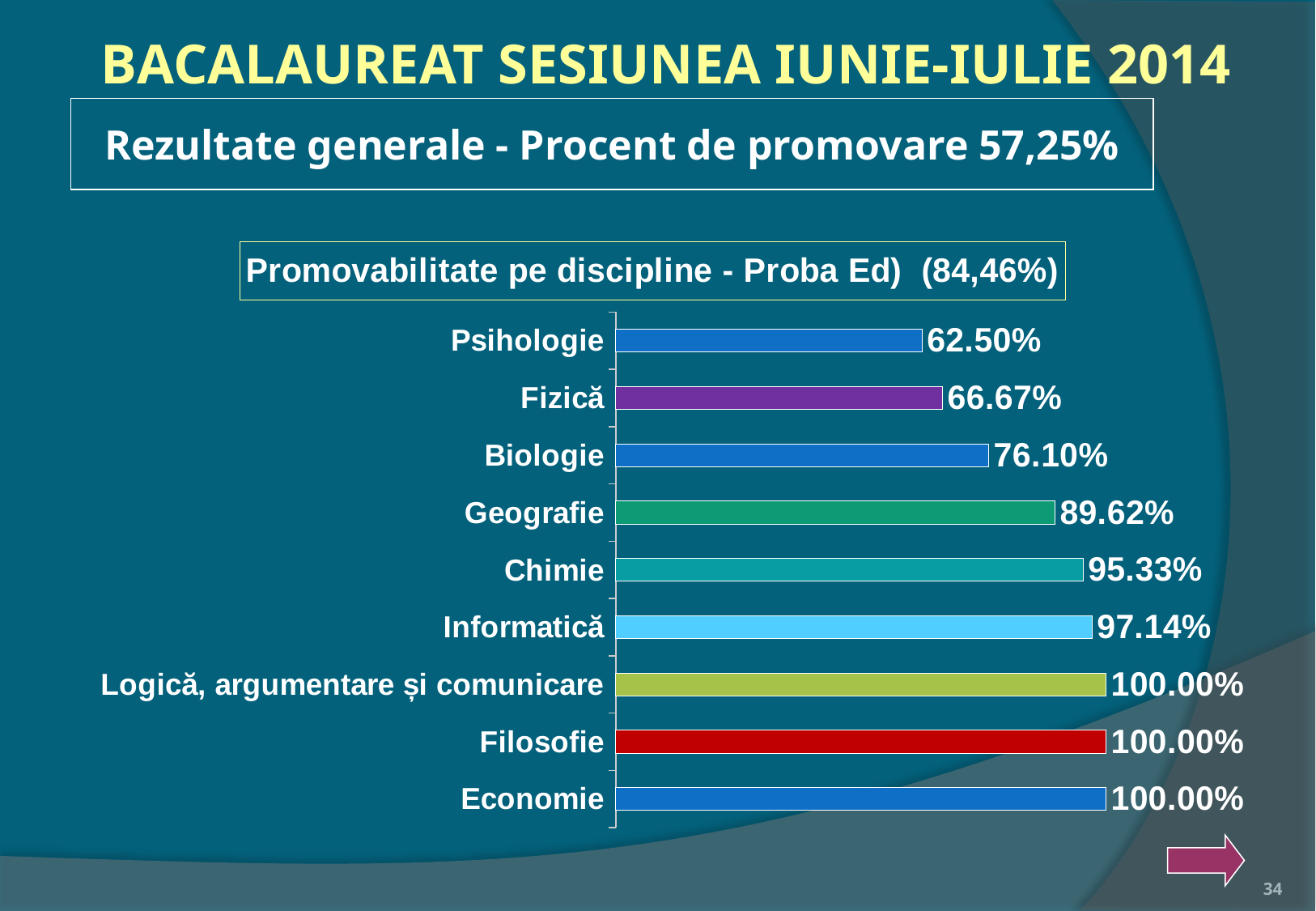
What is the value for Geografie? 89.62% How many disciplines are shown in the chart? 9 Which is larger, the value for Biologie or the value for Geografie? Geografie What is the difference between the values for Chimie and Geografie? 5.71% What kind of chart is shown on the slide? Bar chart How many disciplines have a value of 100.00%? 3 What is the value for Chimie? 95.33% Which discipline has the lowest value? Psihologie What is the value for Psihologie? 62.50% What is the difference between the values for Biologie and Fizică? 9.43% What is the title of the chart? Promovabilitate pe discipline - Proba Ed) (84,46%) What is the value for Informatică? 97.14%